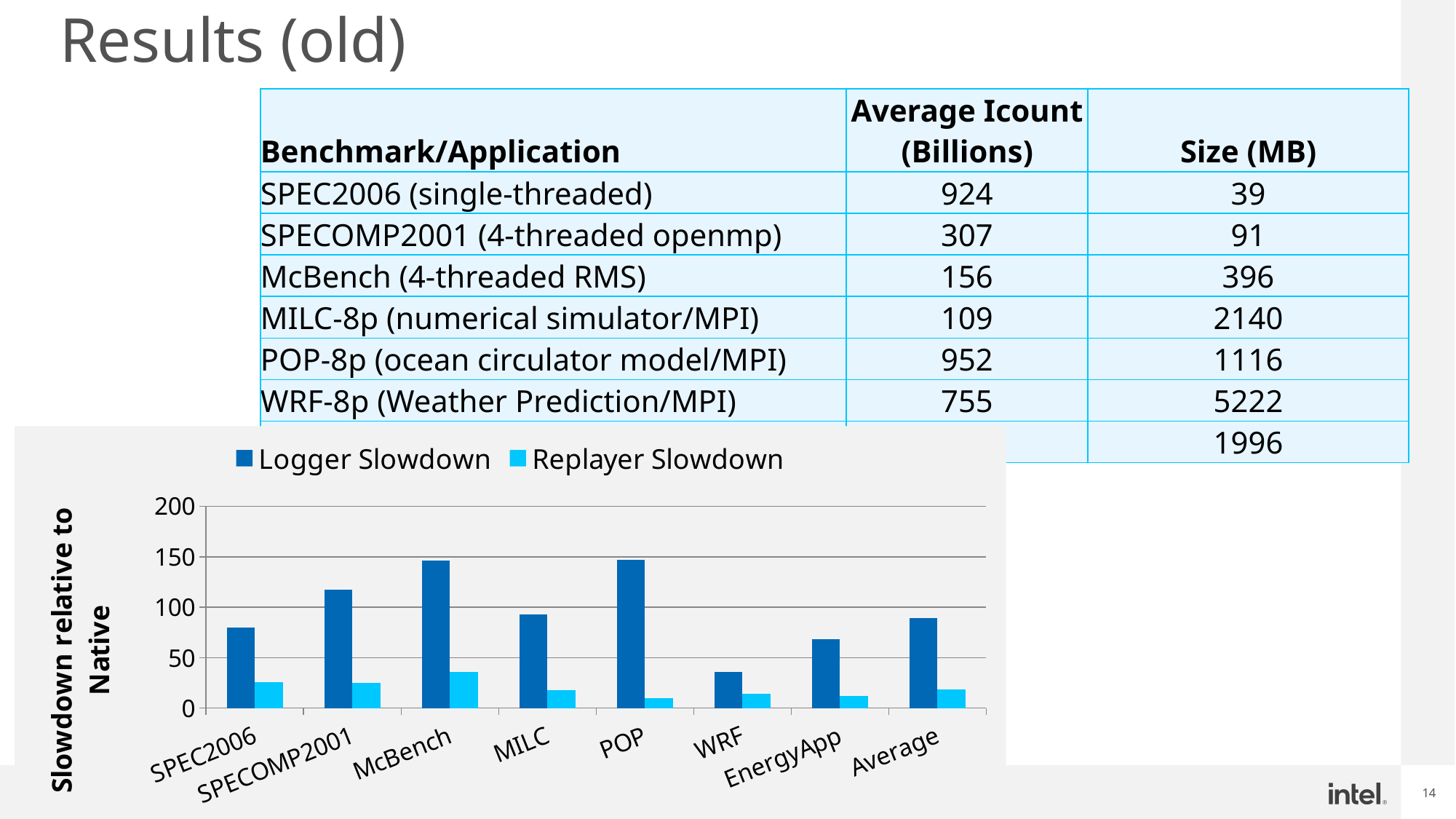
Which has the larger Logger Slowdown: SPEC2006 or SPECOMP2001? SPECOMP2001 Which category has the lowest Logger Slowdown? WRF Is the Logger Slowdown for SPECOMP2001 greater or less than 100? greater What is the label of the chart's vertical axis? Slowdown relative to Native Is the Logger Slowdown for EnergyApp greater or less than 50? greater Is the Logger Slowdown for WRF greater or less than 50? less How many series does the chart legend list? 2 How many categories are shown on the x axis of the chart? 8 What kind of chart is shown on the slide? bar chart Which category has the highest Replayer Slowdown? McBench Which is larger for POP: the Logger Slowdown or the Replayer Slowdown? Logger Slowdown